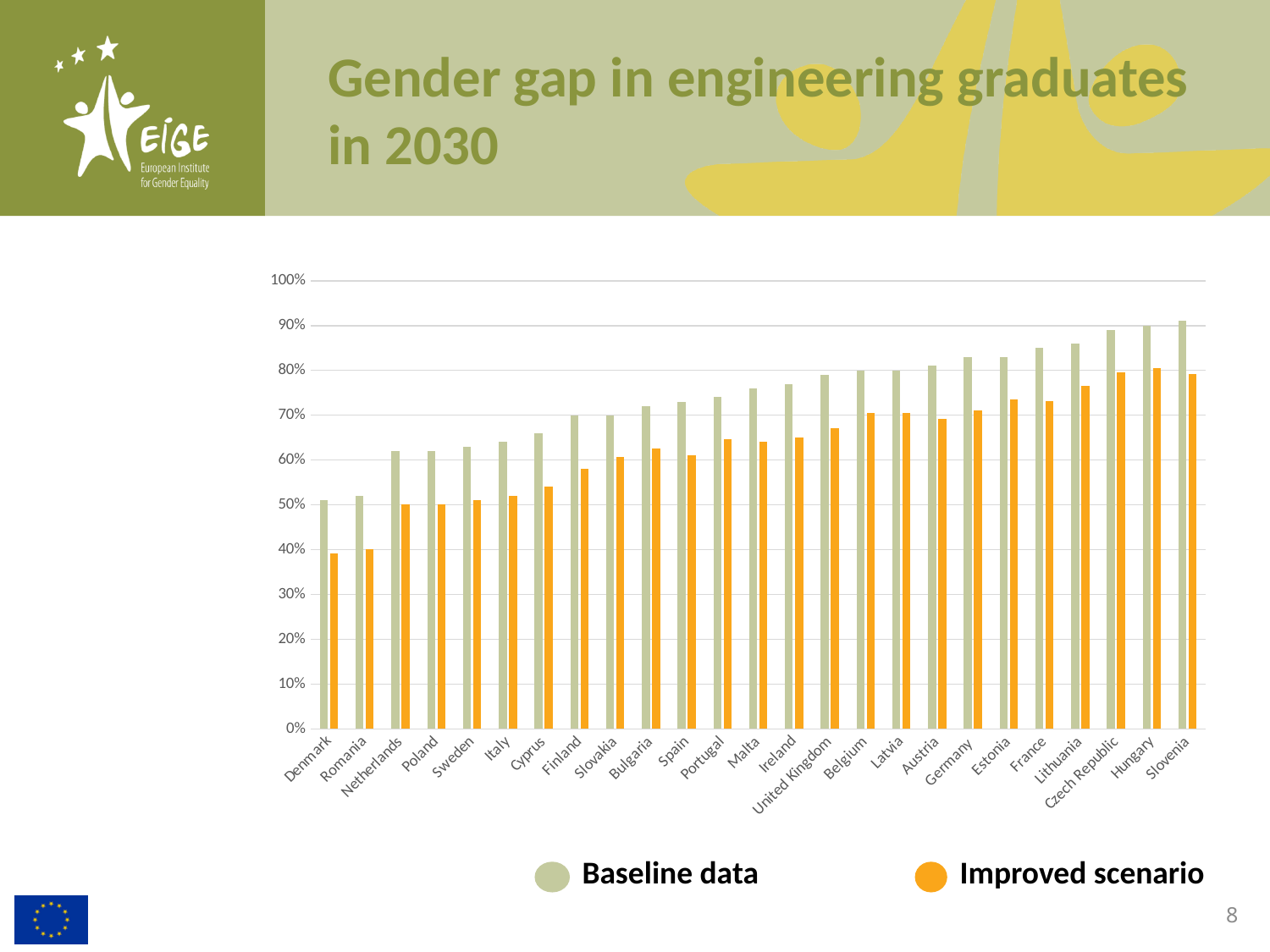
Is the Improved scenario value for Ireland greater or less than 70%? less What kind of chart is shown on the slide? bar chart What are the two series named in the legend? Baseline data and Improved scenario Which is larger, the Baseline data value for Slovenia or for Denmark? Slovenia What is the Baseline data value for Hungary? 90% What is the Baseline data value for Belgium? 80% Is the Baseline data value for Cyprus greater or less than 70%? less Is the Baseline data value for Malta greater or less than 70%? greater How many series does the legend list? 2 Do the Baseline data values rise or fall from left to right along the x axis? rise How many countries are shown on the x axis of the chart? 25